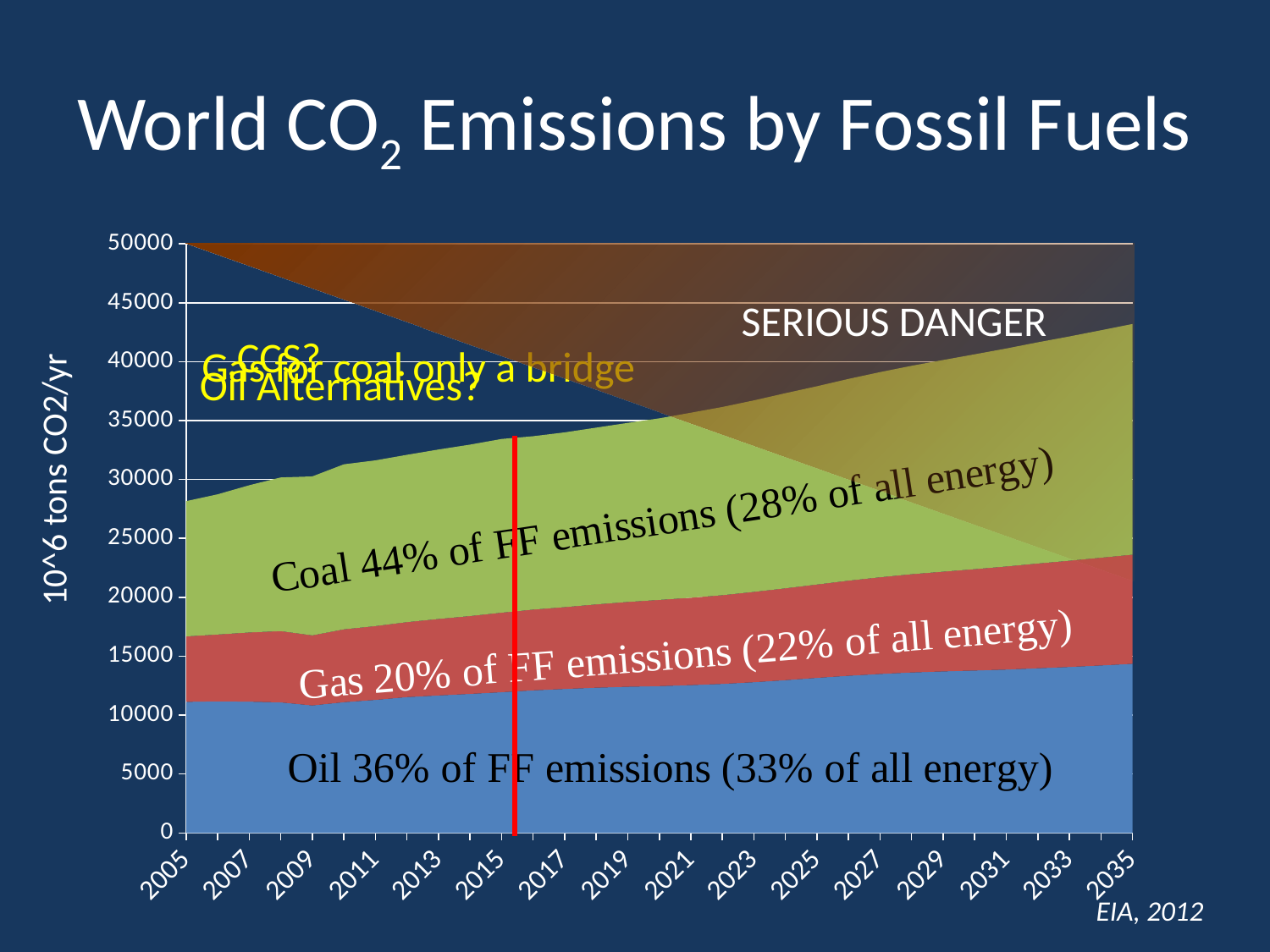
What kind of chart is shown on the slide? Stacked area chart What is the label on the vertical axis? 10^6 tons CO2/yr According to the label on the chart, what percentage of all energy does gas account for? 22% What is the title of the slide's chart? World CO2 Emissions by Fossil Fuels Is the oil emissions value in 2005 greater or less than 10000? greater Do total CO2 emissions rise or fall from 2005 to 2035 in the chart? Rise Is the total CO2 emissions value in 2035 greater or less than 40000? greater How many fossil fuel series are plotted in the chart? 3 According to the label on the chart, what percentage of fossil fuel emissions comes from coal? 44% Which fossil fuel accounts for the largest share of fossil fuel emissions according to the chart labels? Coal According to the label on the chart, what percentage of fossil fuel emissions comes from oil? 36% Which fossil fuel accounts for the smallest share of fossil fuel emissions according to the chart labels? Gas